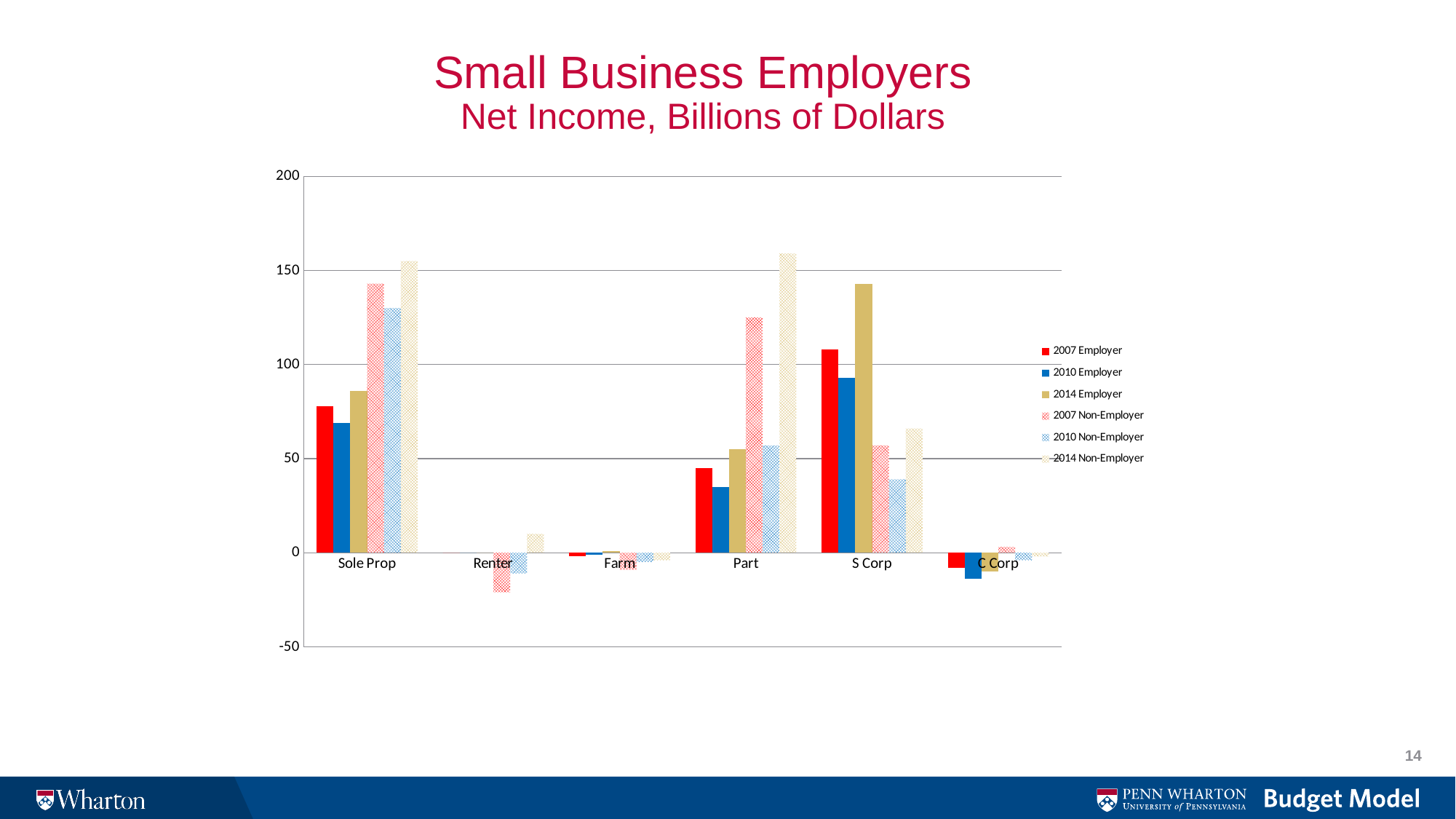
What kind of chart is shown on the slide? Bar chart What is the title of the chart on the slide? Small Business Employers Net Income, Billions of Dollars Which category has the highest 2014 Non-Employer value? Part Which category has the lowest 2007 Non-Employer value? Renter Which category has the highest 2014 Employer value? S Corp For Sole Prop, which is larger: the 2007 Employer value or the 2010 Employer value? 2007 Employer Is the 2014 Non-Employer value for Part greater or less than 150? greater Is the 2007 Employer value for S Corp greater or less than 100? greater How many business categories are shown on the x axis? 6 For S Corp, which is larger: the 2014 Employer value or the 2007 Employer value? 2014 Employer Is the 2010 Employer value for Sole Prop greater or less than 50? greater How many series does the legend list? 6